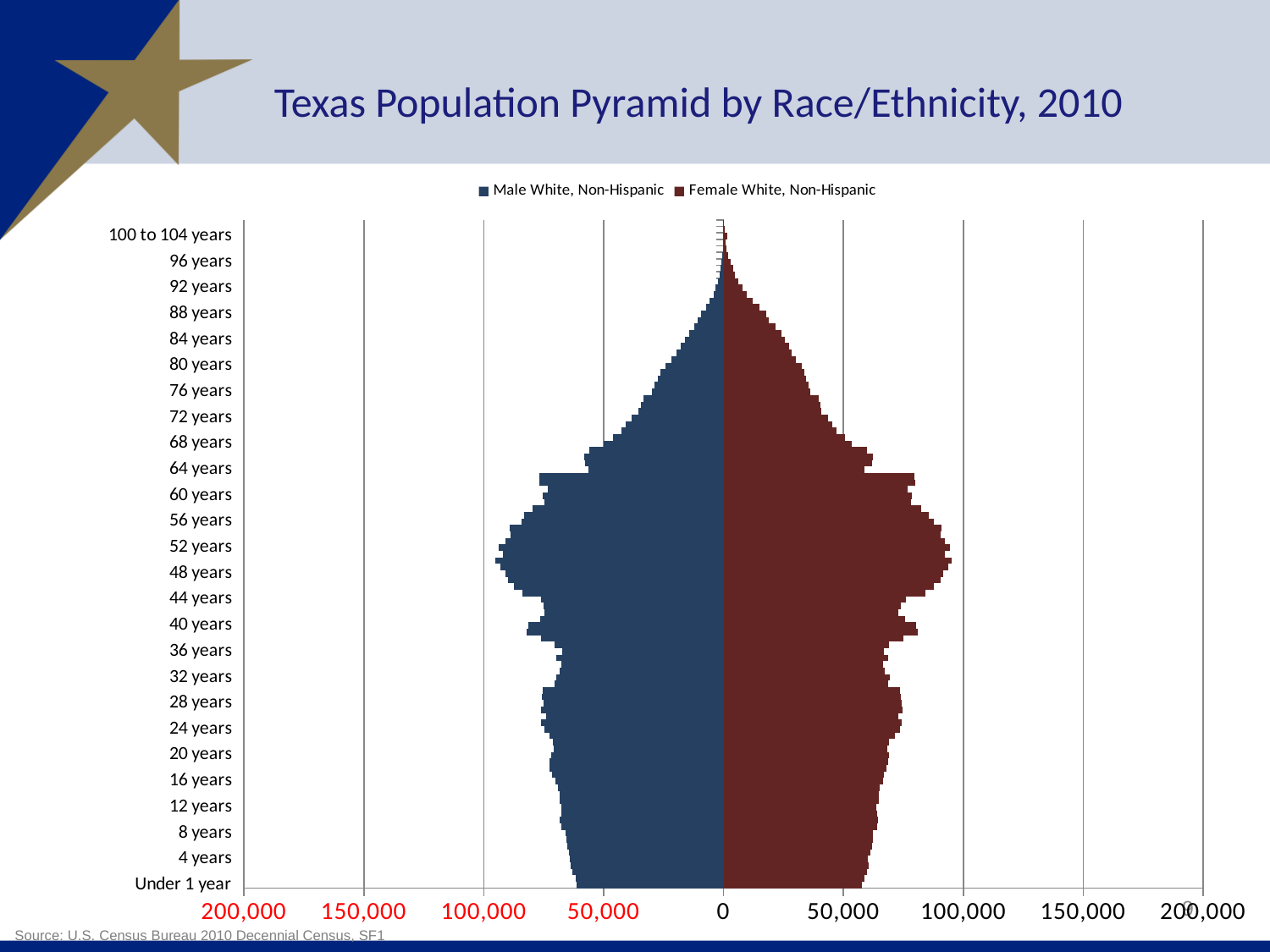
What is the title of the chart? Texas Population Pyramid by Race/Ethnicity, 2010 Is the value for Female White, Non-Hispanic at 60 years greater or less than 50,000? greater Is the value for Male White, Non-Hispanic at 40 years greater or less than 50,000? greater Is the value for Female White, Non-Hispanic at 80 years greater or less than 50,000? less What type of chart is shown on the slide? Bar chart (population pyramid) How many age labels are shown on the vertical axis? 26 Do the bars get shorter or longer as age increases from 60 years up to 100 to 104 years? shorter How many series does the legend list? 2 Which series is shown in dark red? Female White, Non-Hispanic At 88 years, which is larger: the Male White, Non-Hispanic bar or the Female White, Non-Hispanic bar? Female White, Non-Hispanic